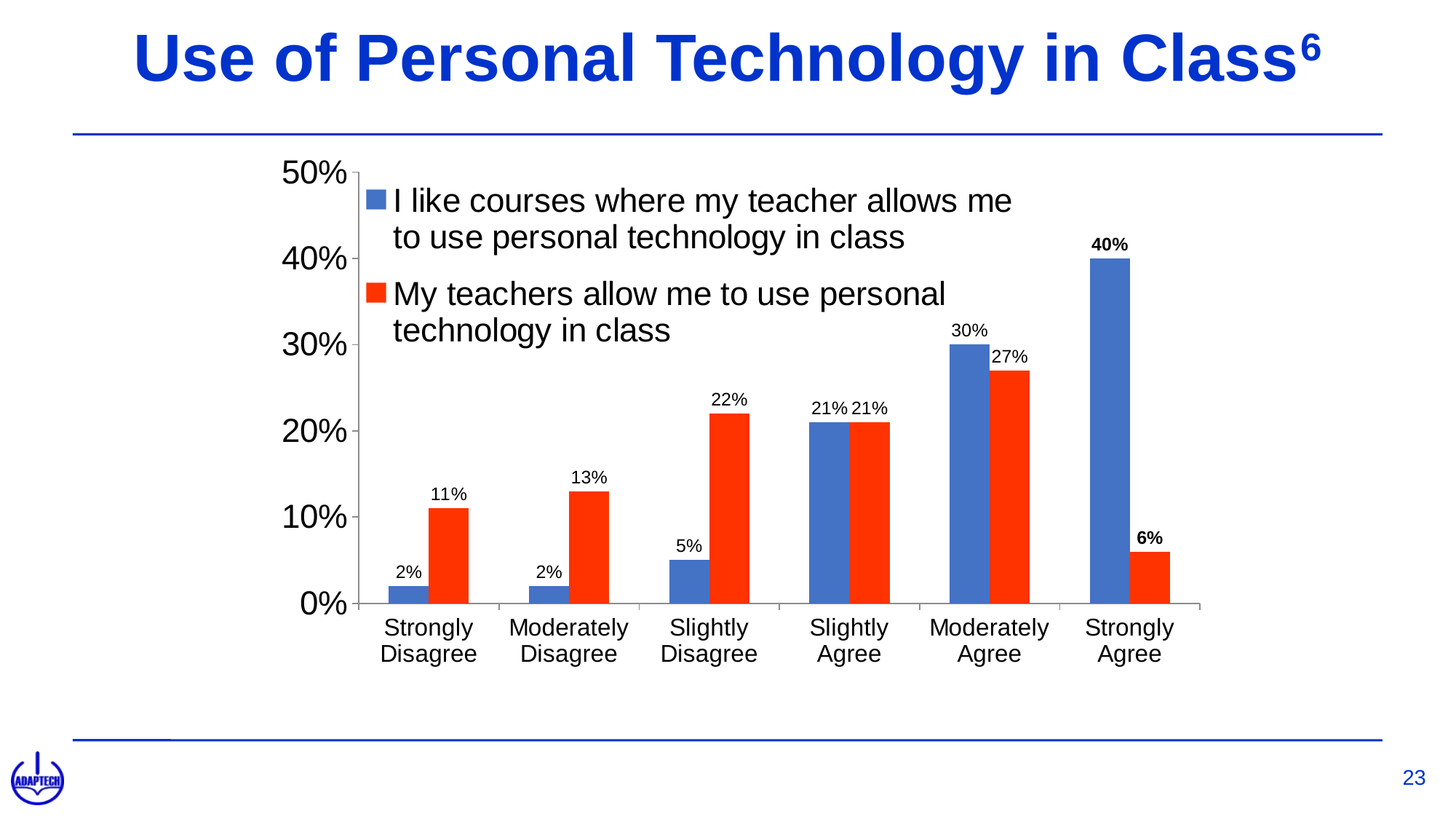
For Moderately Disagree, which series has the larger value? My teachers allow me to use personal technology in class What colour represents the series "My teachers allow me to use personal technology in class"? Red Which category has the highest value in the series "I like courses where my teacher allows me to use personal technology in class"? Strongly Agree What is the value for Strongly Agree in the series "I like courses where my teacher allows me to use personal technology in class"? 40% What is the value for Moderately Agree in the series "My teachers allow me to use personal technology in class"? 27% Which category has the lowest value in the series "My teachers allow me to use personal technology in class"? Strongly Agree How many categories are shown on the x axis? 6 How many series does the legend list? 2 What is the difference between the two series for Slightly Disagree? 17% What kind of chart is shown on the slide? Bar chart What is the value for Slightly Disagree in the series "My teachers allow me to use personal technology in class"? 22% What is the difference between the two series for Strongly Agree? 34%